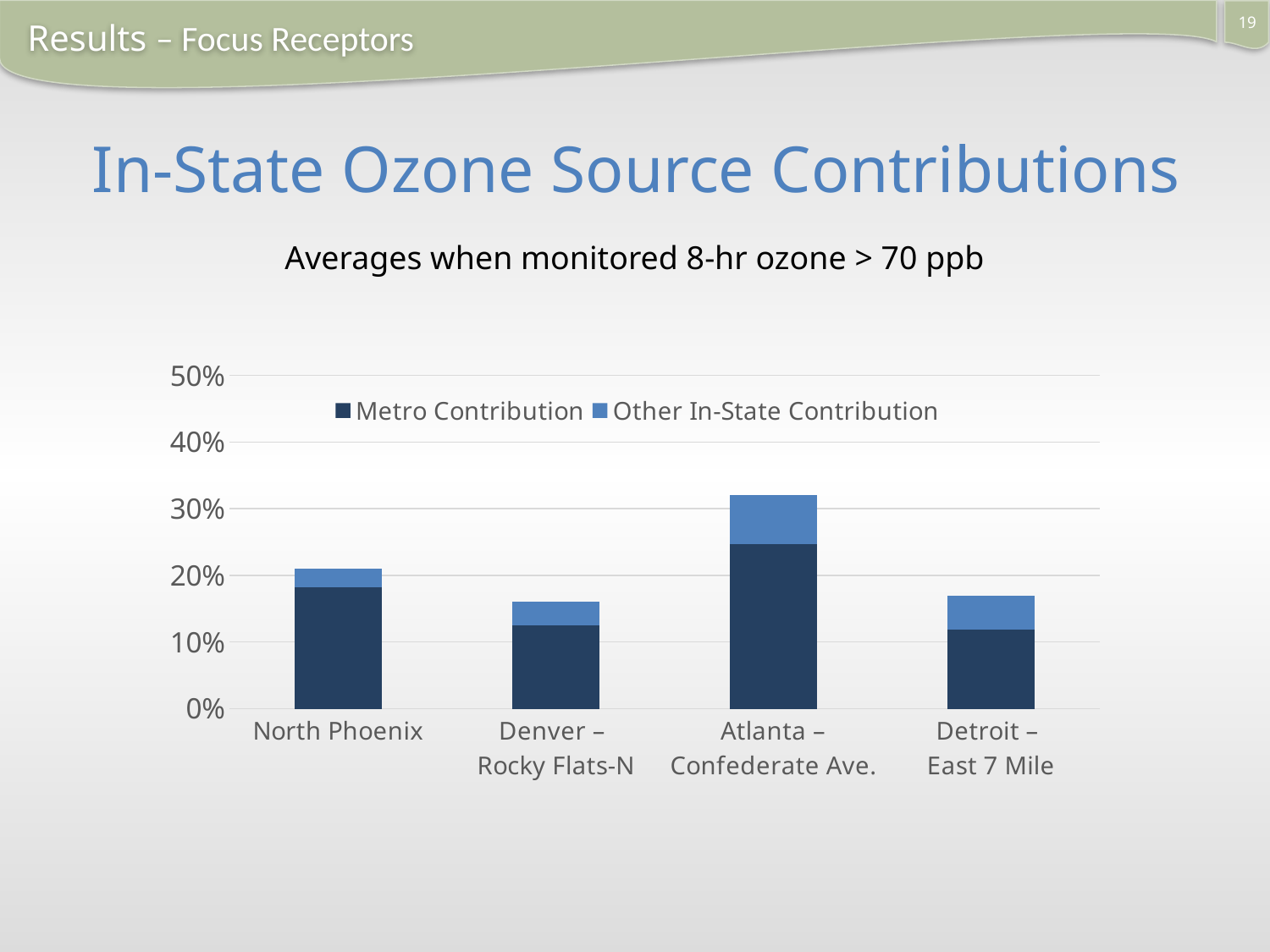
Is the total bar for Denver – Rocky Flats-N greater or less than 20%? less Is the Metro Contribution for North Phoenix greater or less than 20%? less What are the two series named in the chart's legend? Metro Contribution and Other In-State Contribution Is the total bar for Atlanta – Confederate Ave. greater or less than 30%? greater Which has the larger total in-state contribution, North Phoenix or Denver – Rocky Flats-N? North Phoenix Which receptor has the highest total in-state ozone contribution? Atlanta – Confederate Ave. How many receptor locations (categories) are shown on the x axis of the chart? 4 What kind of chart is shown on the slide? Stacked bar chart How many series does the chart's legend list? 2 Which has the larger Metro Contribution, North Phoenix or Detroit – East 7 Mile? North Phoenix Which receptor has the largest Metro Contribution? Atlanta – Confederate Ave.